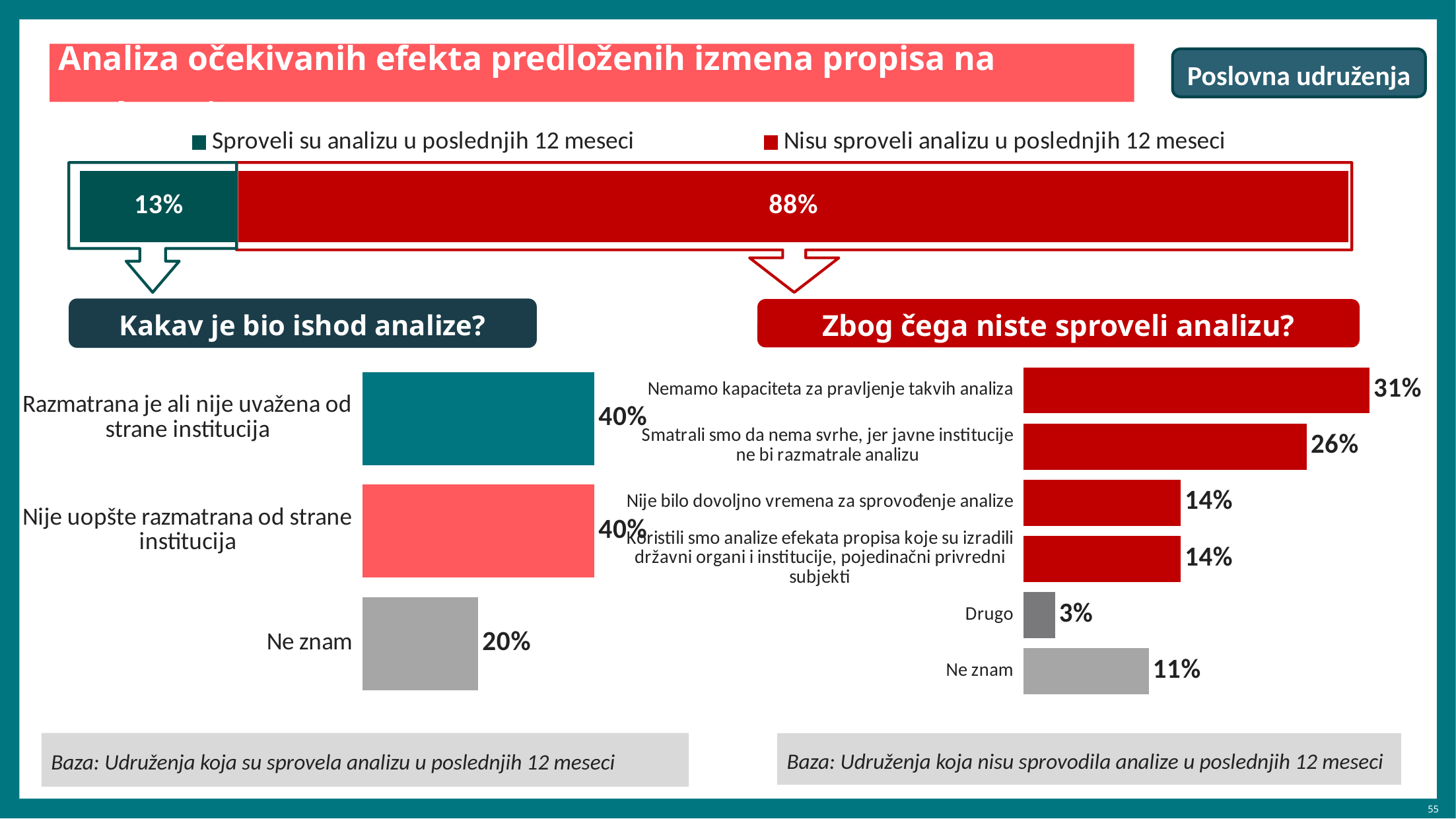
In the chart 'Zbog čega niste sproveli analizu?', what is the difference between the values for 'Nemamo kapaciteta za pravljenje takvih analiza' and 'Smatrali smo da nema svrhe, jer javne institucije ne bi razmatrale analizu'? 5% In the chart 'Zbog čega niste sproveli analizu?', what is the value for 'Nemamo kapaciteta za pravljenje takvih analiza'? 31% In the chart 'Zbog čega niste sproveli analizu?', which category has the lowest value? Drugo How many series does the legend of the top stacked bar chart list? 2 In the top stacked bar chart, what percentage of associations conducted an analysis in the last 12 months (Sproveli su analizu u poslednjih 12 meseci)? 13% In the chart 'Kakav je bio ishod analize?', what is the value for 'Ne znam'? 20% In the chart 'Zbog čega niste sproveli analizu?', which is larger: the value for 'Ne znam' or the value for 'Drugo'? Ne znam In the chart 'Kakav je bio ishod analize?', which category has the lowest value? Ne znam How many categories are shown in the chart 'Zbog čega niste sproveli analizu?'? 6 In the chart 'Zbog čega niste sproveli analizu?', which category has the highest value? Nemamo kapaciteta za pravljenje takvih analiza In the top stacked bar chart, what is the value for 'Nisu sproveli analizu u poslednjih 12 meseci'? 88% How many categories are shown in the chart 'Kakav je bio ishod analize?'? 3